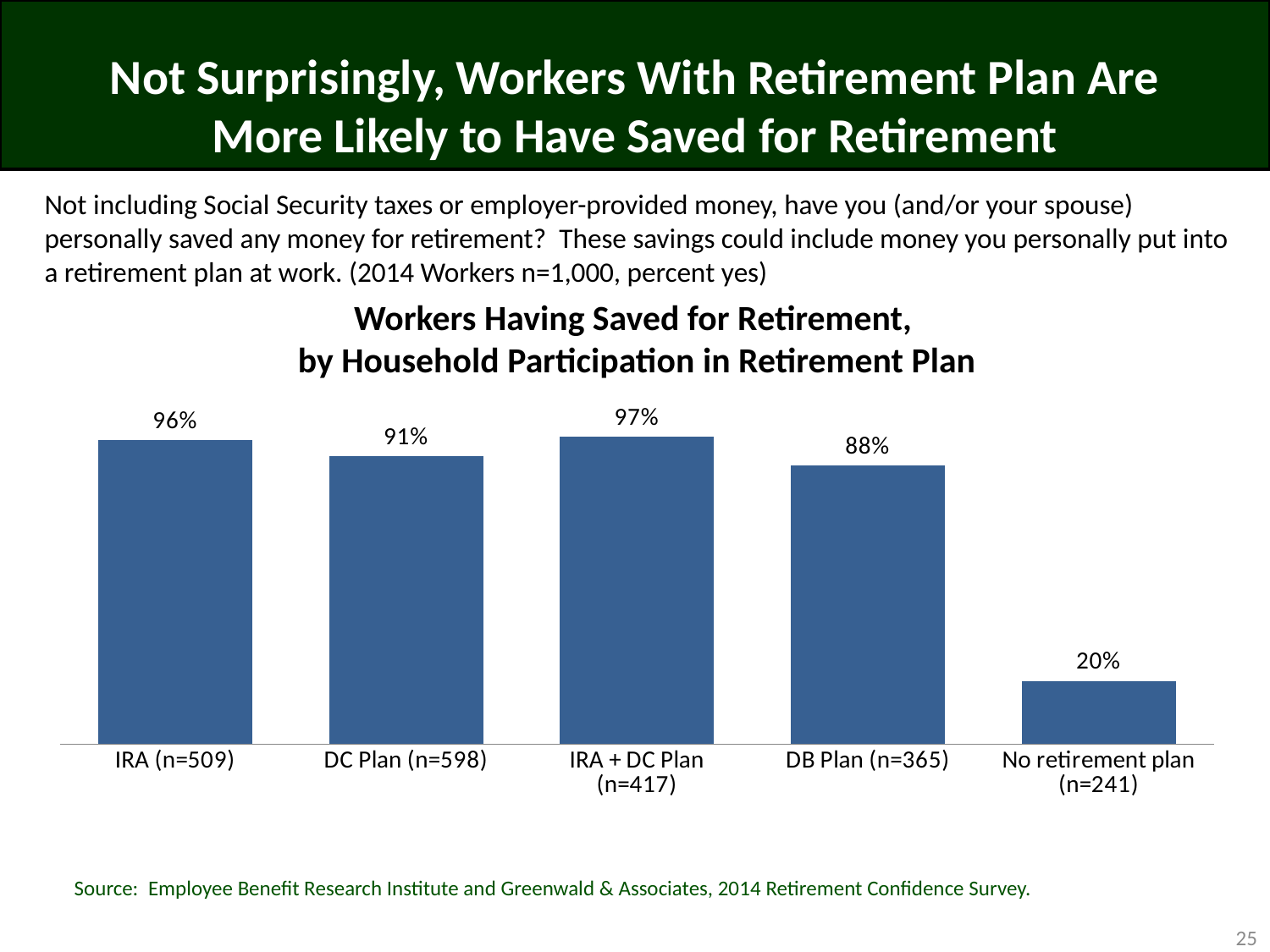
Which is larger, the value for IRA (n=509) or the value for DB Plan (n=365)? IRA (n=509) What is the title of the chart? Workers Having Saved for Retirement, by Household Participation in Retirement Plan What percentage is shown for workers with no retirement plan (n=241)? 20% What is the value shown for DB Plan (n=365)? 88% What is the difference in percentage points between IRA (n=509) and DC Plan (n=598)? 5 What is the difference in percentage points between DB Plan (n=365) and No retirement plan (n=241)? 68 Which category has the lowest percentage of workers having saved for retirement? No retirement plan (n=241) What percentage of workers with an IRA (n=509) have saved for retirement? 96% What is the value shown for DC Plan (n=598)? 91% How many categories are shown in the chart? 5 What kind of chart is shown on the slide? Bar chart Which category has the highest percentage of workers having saved for retirement? IRA + DC Plan (n=417)